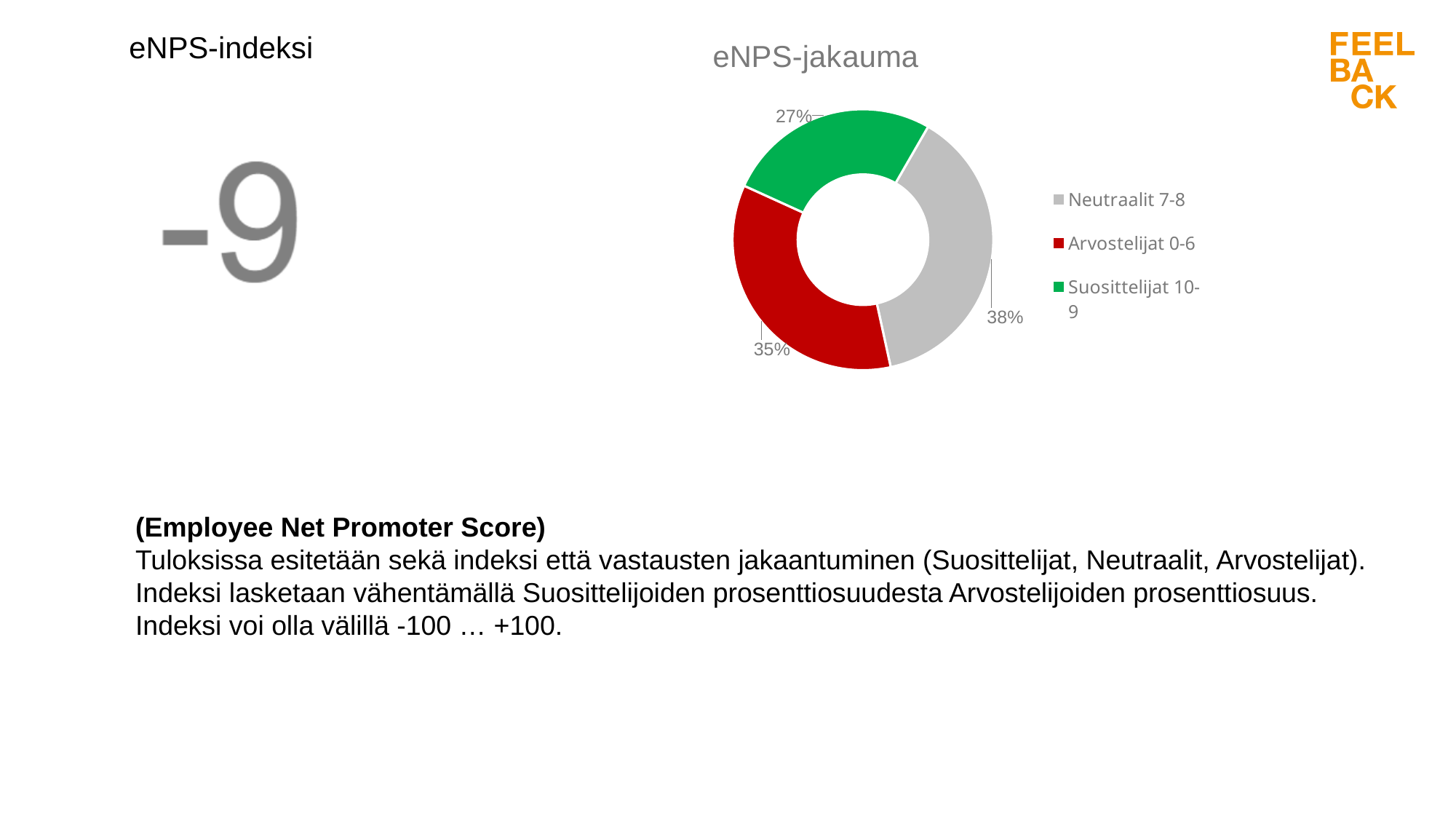
What share of the eNPS-jakauma chart is Neutraalit 7-8? 38% How many categories does the eNPS-jakauma chart show? 3 What share of the eNPS-jakauma chart is Suosittelijat 10-9? 27% Which category has the largest share in the eNPS-jakauma chart? Neutraalit 7-8 Which category has the smallest share in the eNPS-jakauma chart? Suosittelijat 10-9 What colour represents Suosittelijat 10-9 in the eNPS-jakauma chart? Green In the eNPS-jakauma chart, which is larger: Arvostelijat 0-6 or Suosittelijat 10-9? Arvostelijat 0-6 What is the title of the chart on the slide? eNPS-jakauma What share of the eNPS-jakauma chart is Arvostelijat 0-6? 35% In the eNPS-jakauma chart, what is the difference in percentage points between Neutraalit 7-8 and Suosittelijat 10-9? 11 In the eNPS-jakauma chart, what is the difference in percentage points between Arvostelijat 0-6 and Suosittelijat 10-9? 8 What kind of chart is the eNPS-jakauma chart? Doughnut (pie) chart